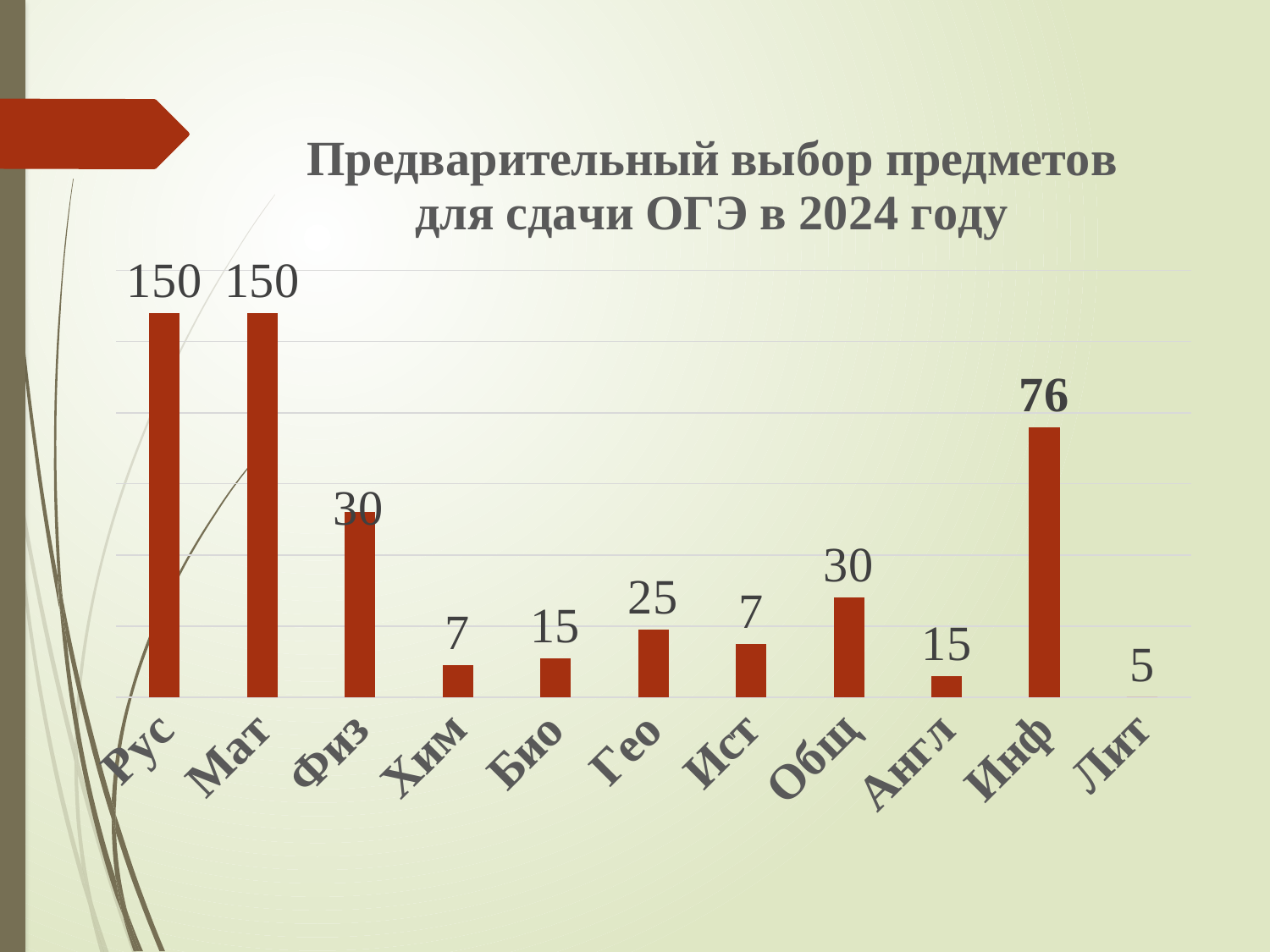
Which is larger, the value for Гео or the value for Англ? Гео What is the difference between the values for Мат and Инф? 74 What is the value for Лит? 5 What is the value for Инф? 76 Which category has the lowest value? Лит What is the title of the chart? Предварительный выбор предметов для сдачи ОГЭ в 2024 году What kind of chart is shown on the slide? Bar chart Which is larger, the value for Инф or the value for Общ? Инф How many categories are shown on the x axis? 11 What is the value for Физ? 30 What is the difference between the values for Общ and Хим? 23 What is the value for Гео? 25